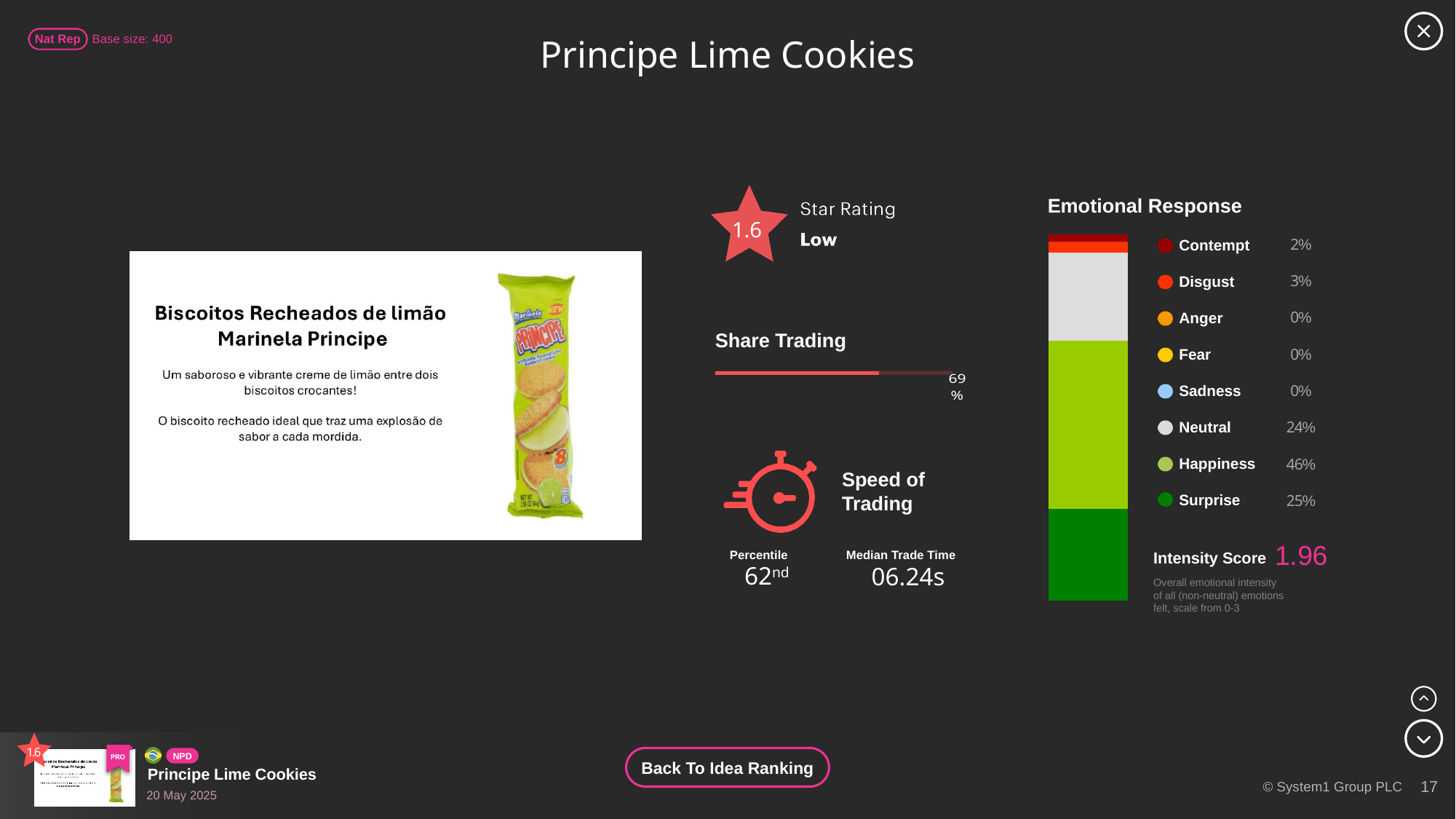
In the Emotional Response chart, what percentage is shown for Disgust? 3% How many emotions in the Emotional Response chart are shown at 0%? 3 What kind of chart is the Emotional Response chart? Stacked bar chart In the Emotional Response chart, which is larger, Happiness or Neutral? Happiness In the Emotional Response chart, what percentage is shown for Neutral? 24% In the Emotional Response chart, what percentage is shown for Happiness? 46% In the Emotional Response chart, what is the difference between the Happiness and Surprise percentages? 21% What Intensity Score is shown next to the Emotional Response chart? 1.96 How many emotions are listed in the Emotional Response chart? 8 In the Emotional Response chart, what percentage is shown for Surprise? 25% In the Emotional Response chart, which emotion has the highest percentage? Happiness What is the Share Trading value shown on the slide? 69%